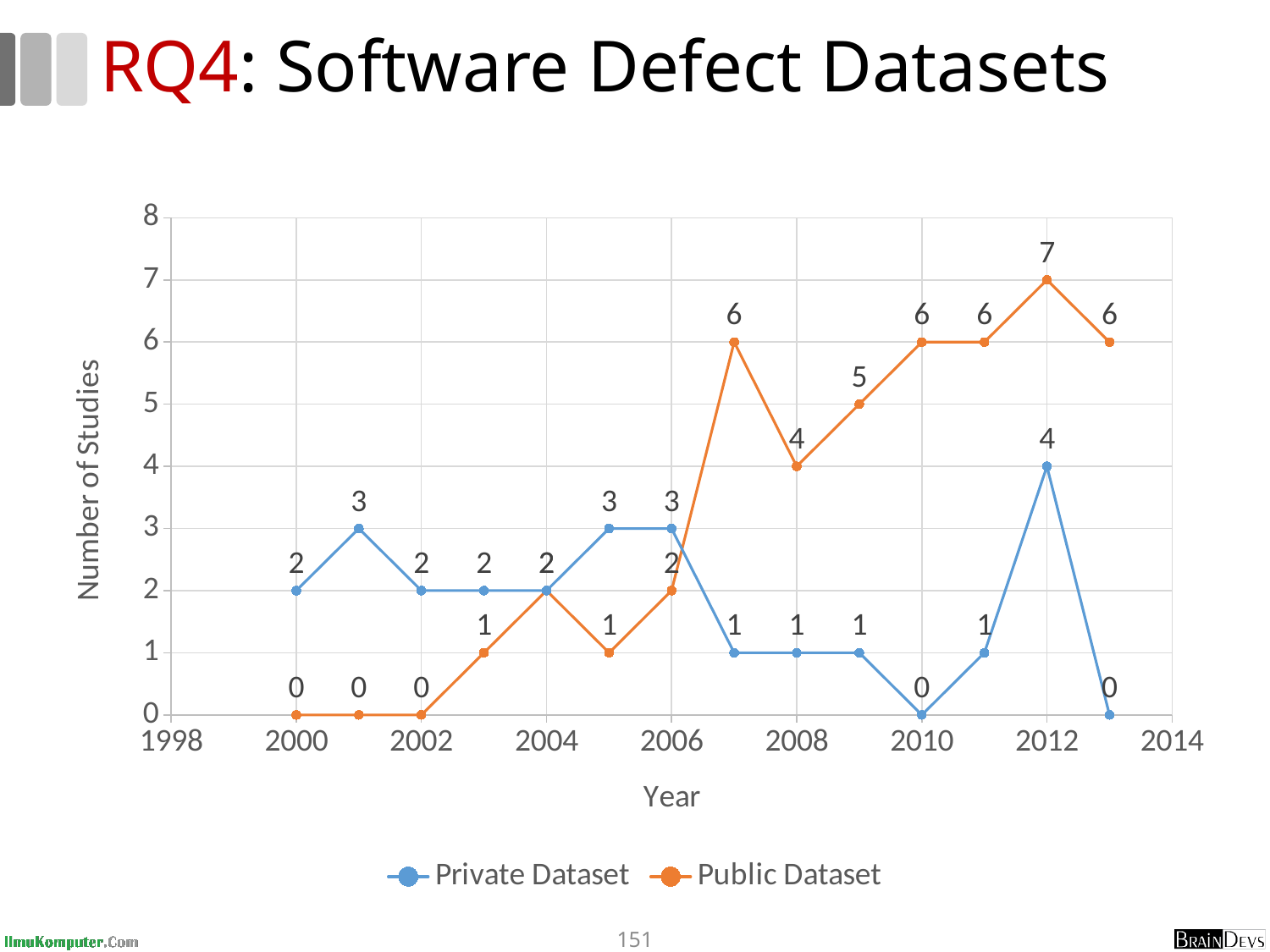
In which year does the Private Dataset series reach its highest value? 2012 Which series has the larger value in 2013, Private Dataset or Public Dataset? Public Dataset What kind of chart is shown on the slide? Line chart What is the value for Public Dataset in 2012? 7 Does the Public Dataset series generally rise or fall from 2000 to 2013? Rise What is the label of the y axis? Number of Studies What is the difference between Public Dataset and Private Dataset in 2007? 5 How many series does the legend list? 2 In which year does the Public Dataset series reach its highest value? 2012 What is the value for Public Dataset in 2008? 4 Which series has the larger value in 2001, Private Dataset or Public Dataset? Private Dataset What is the value for Private Dataset in 2012? 4